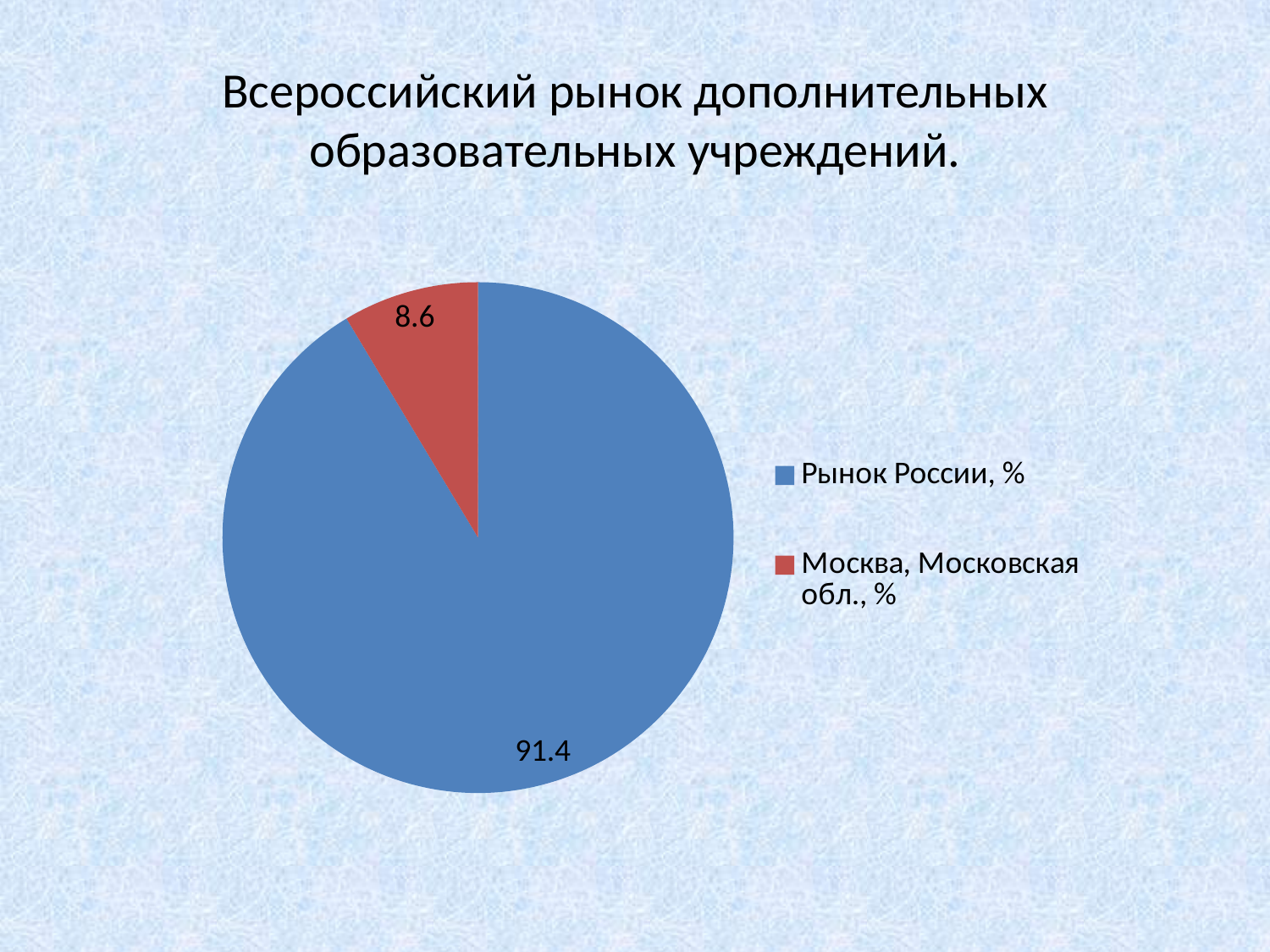
What is the difference between the values for Рынок России, % and Москва, Московская обл., %? 82.8 How many slices does the pie chart have? 2 Which is larger: Рынок России, % or Москва, Московская обл., %? Рынок России, % Which slice is the largest? Рынок России, % What is the title of the slide? Всероссийский рынок дополнительных образовательных учреждений. What is the total of the two slice values? 100 What is the value for Рынок России, %? 91.4 How many entries does the legend list? 2 What is the value for Москва, Московская обл., %? 8.6 Which slice is the smallest? Москва, Московская обл., % What type of chart is shown on the slide? pie chart What colour is the slice for Москва, Московская обл., %? red